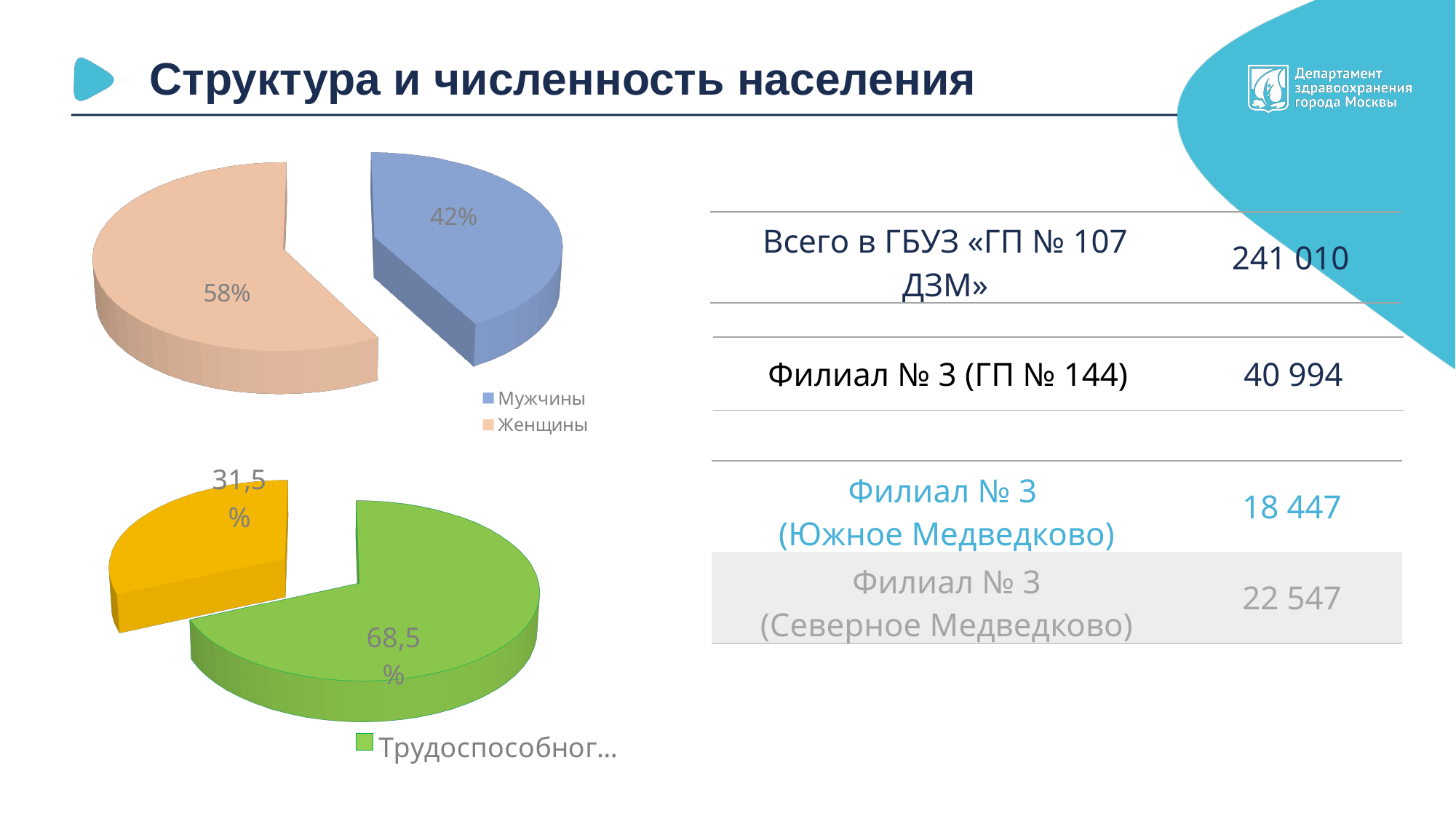
In the top pie chart, what share is shown for Мужчины? 42% In the top pie chart, which category has the largest slice? Женщины In the bottom pie chart, what share is shown on the yellow slice? 31,5% What kind of chart is the bottom chart on the slide? Pie chart What kind of chart is the top chart on the slide? Pie chart Which two entries does the legend of the top pie chart list? Мужчины and Женщины In the top pie chart, by how many percentage points does Женщины exceed Мужчины? 16 percentage points In the bottom pie chart, which slice is larger, the green one or the yellow one? The green one In the top pie chart, what share is shown for Женщины? 58% How many slices does the top pie chart have? 2 In the bottom pie chart, what share is shown on the green slice? 68,5% In the top pie chart, which category has the smallest slice? Мужчины